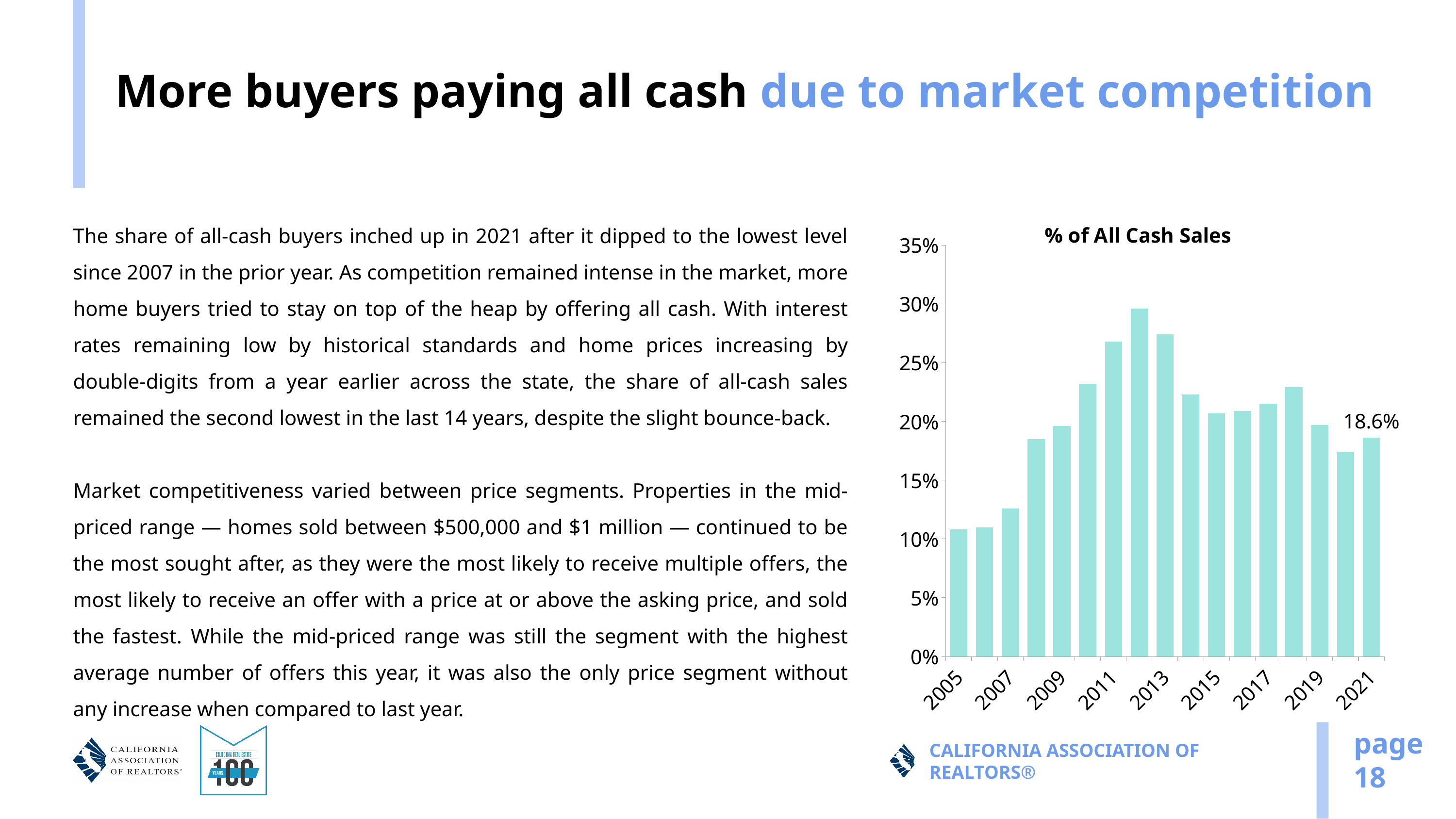
Is the value for 2010 greater or less than 20%? greater Is the value for 2012 greater or less than 25%? greater What is the value of the bar for 2021? 18.6% Do the values rise or fall from 2005 to 2012? rise What is the title of the chart? % of All Cash Sales Is the value for 2005 greater or less than 15%? less Which is larger, the value for 2007 or the value for 2018? 2018 Which year has the highest share of all cash sales? 2012 How many bars (years) are plotted in the chart? 17 Which is larger, the value for 2011 or the value for 2015? 2011 What type of chart is shown on the slide? bar chart